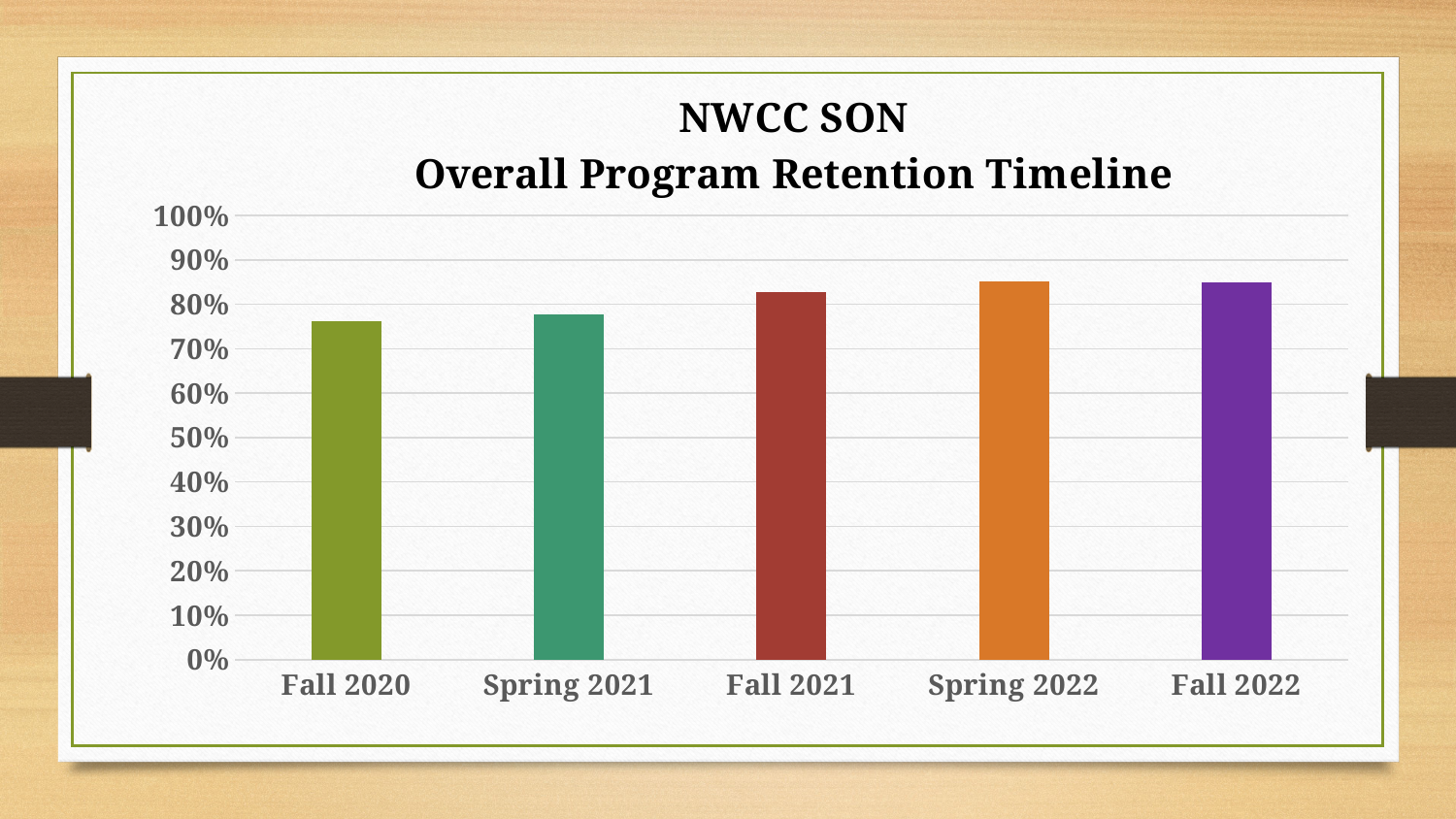
Which is larger, the value for Spring 2021 or the value for Spring 2022? Spring 2022 What is the title of the chart? NWCC SON Overall Program Retention Timeline Is the value for Fall 2022 greater or less than 80%? greater How many categories are shown on the x axis of the chart? 5 Is the value for Fall 2021 greater or less than 80%? greater Do the values generally rise or fall from Fall 2020 to Fall 2022? rise Which is larger, the value for Fall 2020 or the value for Fall 2021? Fall 2021 Is the value for Spring 2022 greater or less than 90%? less What is the highest value shown on the y axis of the chart? 100% What kind of chart is shown on the slide? bar chart